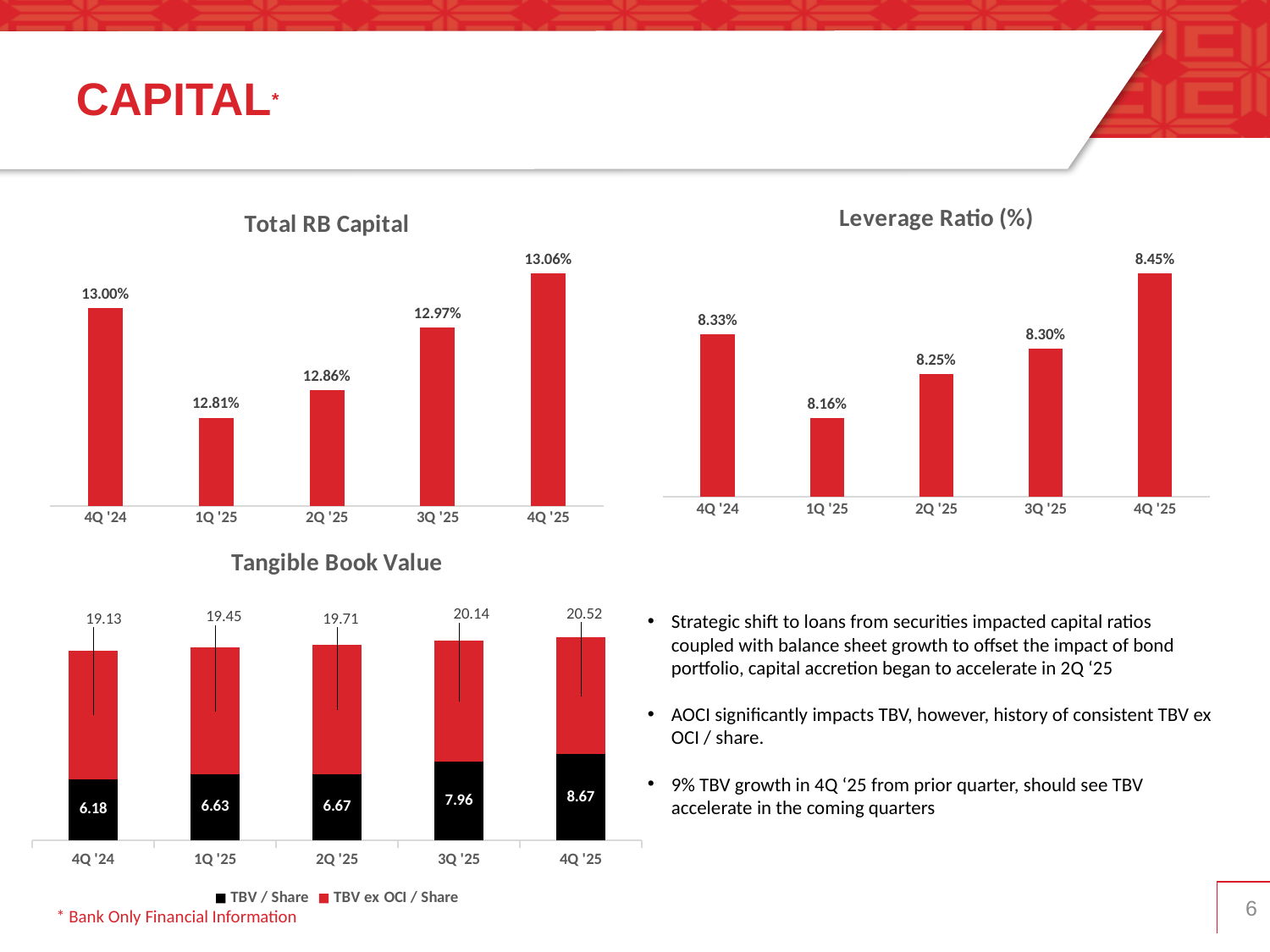
In the Tangible Book Value chart, how many series does the legend list? 2 In the Tangible Book Value chart, what is the TBV / Share value for 3Q '25? 7.96 In the Tangible Book Value chart, do the TBV / Share values rise or fall from 4Q '24 to 4Q '25? rise In the Leverage Ratio (%) chart, what is the value for 2Q '25? 8.25% In the Total RB Capital chart, which quarter has the lowest value? 1Q '25 What kind of chart is the Leverage Ratio (%) chart? bar chart In the Leverage Ratio (%) chart, how many quarters are shown? 5 In the Total RB Capital chart, what is the value for 4Q '25? 13.06% In the Leverage Ratio (%) chart, which is larger, 4Q '24 or 3Q '25? 4Q '24 In the Total RB Capital chart, what is the difference between 4Q '25 and 1Q '25? 0.25% In the Tangible Book Value chart, what value is printed above the 4Q '25 bar? 20.52 In the Leverage Ratio (%) chart, which quarter has the highest value? 4Q '25